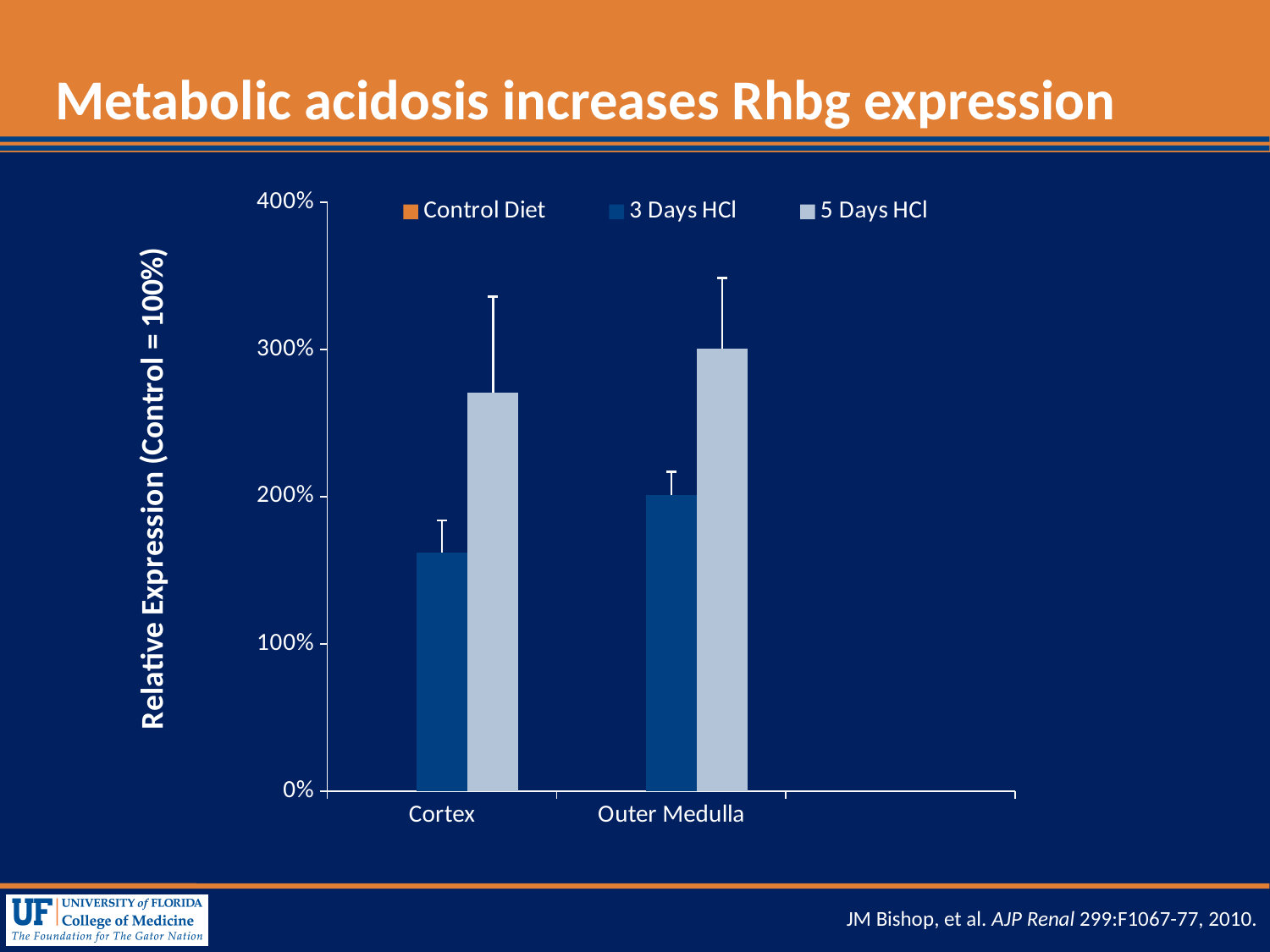
Is the value for 5 Days HCl in Cortex greater or less than 200%? greater Is the value for 3 Days HCl in Cortex greater or less than 200%? less How many series does the chart legend list? 3 What is the first entry in the chart legend? Control Diet For 3 Days HCl, which category has the larger value: Cortex or Outer Medulla? Outer Medulla What kind of chart is shown on the slide? bar chart What is the title of the y axis of the chart? Relative Expression (Control = 100%) How many categories are shown on the x axis of the chart? 2 Which bar is the highest in the chart? 5 Days HCl in Outer Medulla Which is larger in Cortex: the 3 Days HCl value or the 5 Days HCl value? 5 Days HCl